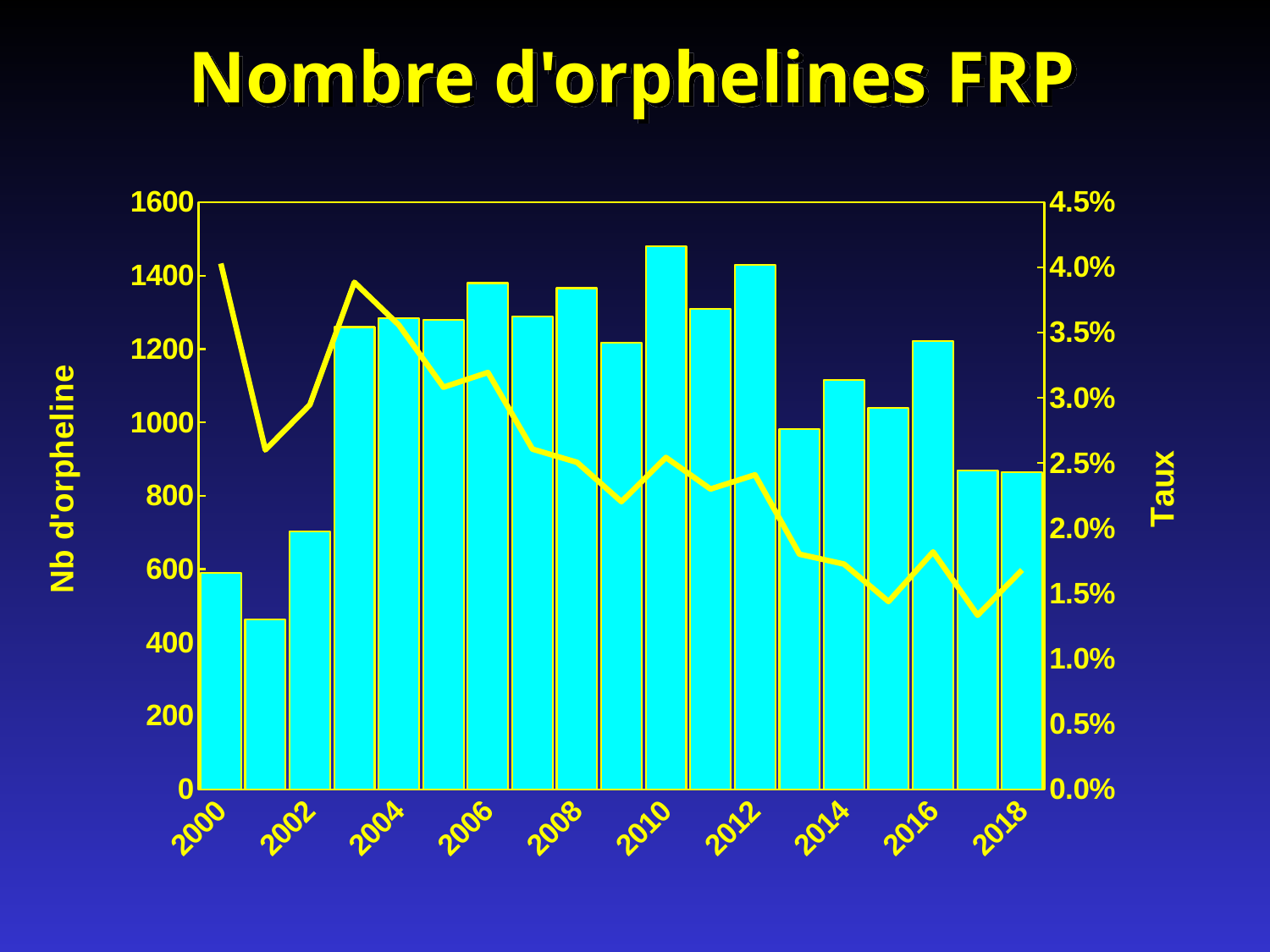
Is the Taux line value for 2000 greater or less than 3.5%? greater How many bars (years) are plotted in the chart? 19 Which year has a taller bar, 2010 or 2013? 2010 What kind of chart is shown on the slide? A bar chart combined with a line chart Is the bar value for 2010 greater or less than 1400? greater Which year has the shortest bar for the number of orphelines? 2001 What is the label of the right-hand vertical axis? Taux Which year has the tallest bar for the number of orphelines? 2010 What is the title of the chart? Nombre d'orphelines FRP Does the Taux line generally rise or fall from 2000 to 2018? fall Is the bar value for 2001 greater or less than 600? less